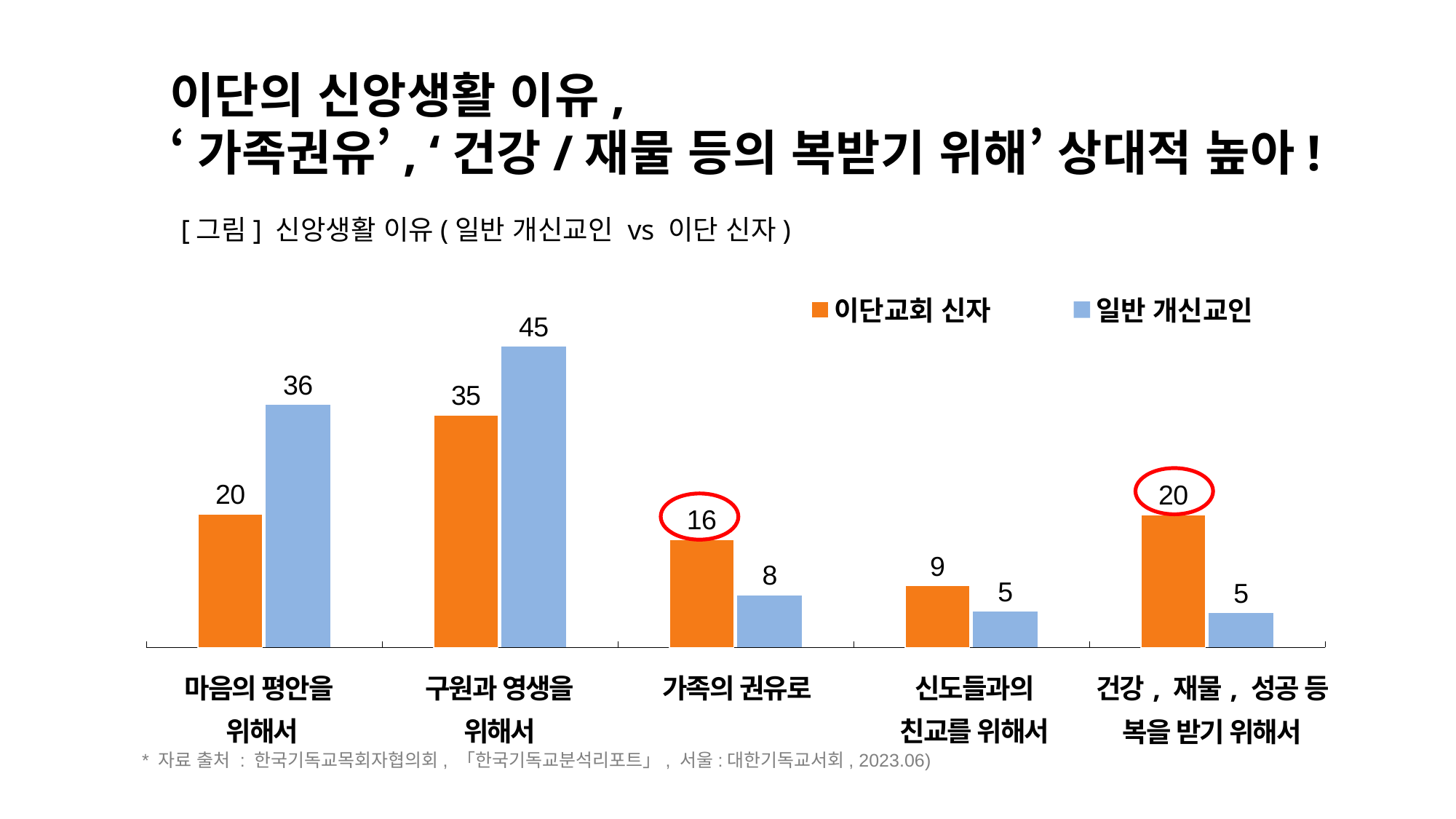
What is the difference between 이단교회 신자 and 일반 개신교인 in the 가족의 권유로 category? 8 What is the value for 이단교회 신자 in the 가족의 권유로 category? 16 In the 건강, 재물, 성공 등 복을 받기 위해서 category, which series has the larger value? 이단교회 신자 What is the value for 이단교회 신자 in the 건강, 재물, 성공 등 복을 받기 위해서 category? 20 How many categories are shown on the x axis? 5 What is the value for 일반 개신교인 in the 구원과 영생을 위해서 category? 45 What kind of chart is shown on the slide? bar chart What is the difference between 일반 개신교인 and 이단교회 신자 in the 마음의 평안을 위해서 category? 16 Which category has the lowest value for 이단교회 신자? 신도들과의 친교를 위해서 Which colour represents 일반 개신교인 in the legend? blue How many series does the legend list? 2 Which category has the highest value for 일반 개신교인? 구원과 영생을 위해서